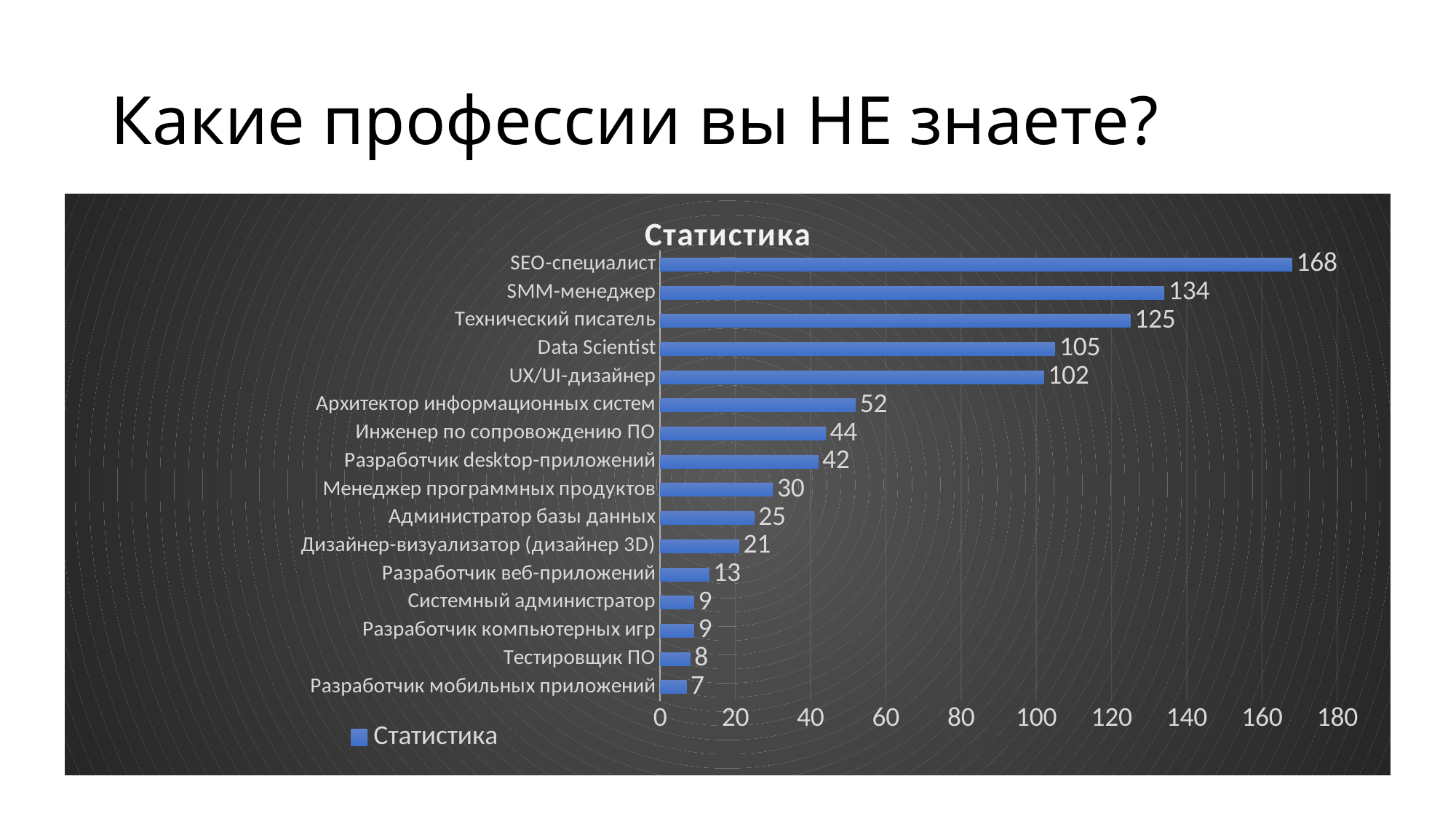
How many categories are shown in the chart? 16 What is the title of the chart? Статистика What is the value for Data Scientist? 105 What kind of chart is shown on the slide? bar chart How many series does the legend list? 1 Which is larger, the value for UX/UI-дизайнер or the value for Архитектор информационных систем? UX/UI-дизайнер Which category has the highest value? SEO-специалист What is the value for SEO-специалист? 168 What is the difference between the values for SEO-специалист and SMM-менеджер? 34 Which category has the lowest value? Разработчик мобильных приложений Is the value for Технический писатель greater or less than 120? greater What is the value for Администратор базы данных? 25